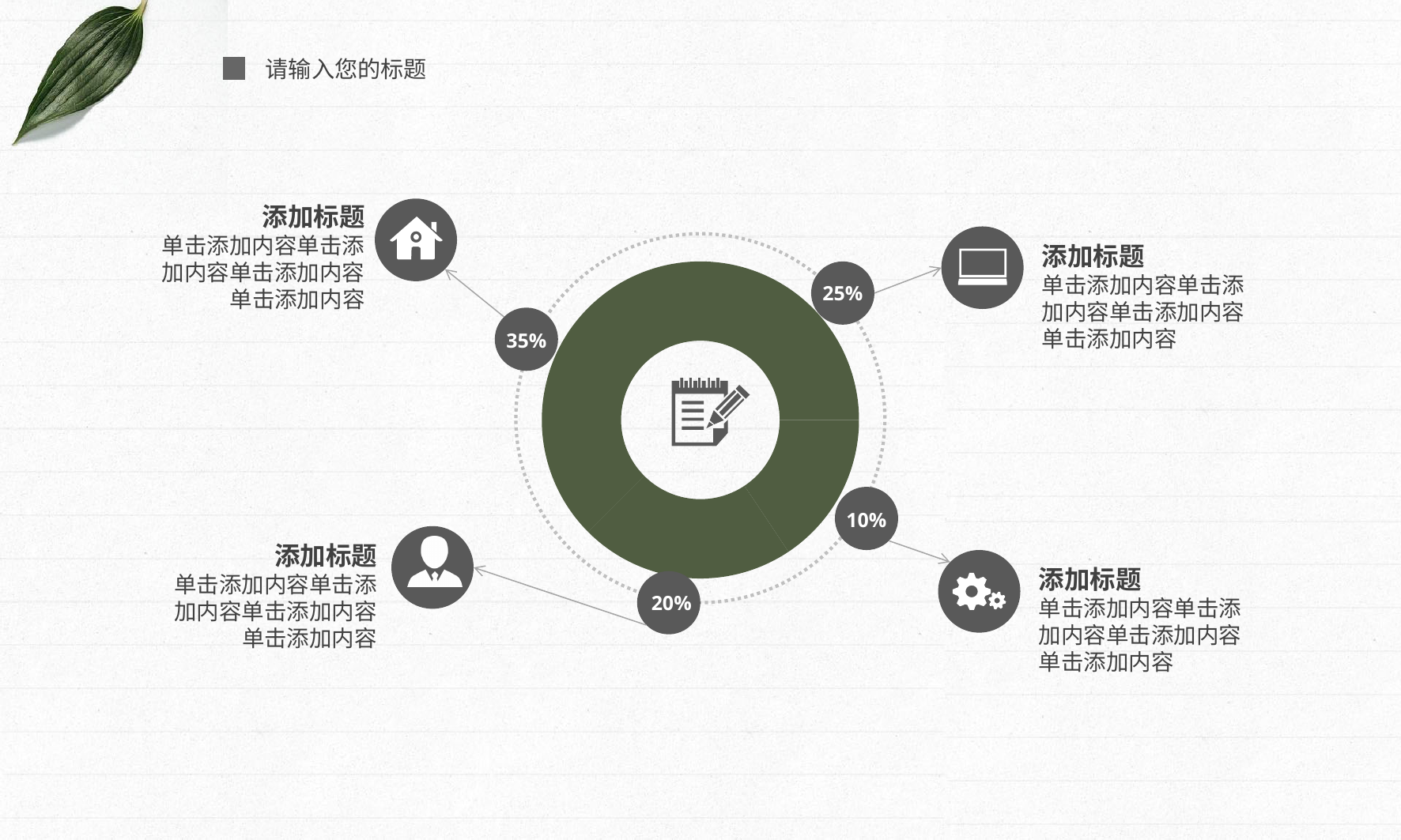
What is the smallest percentage shown on the donut chart? 10% What kind of chart is shown in the centre of the slide? Pie chart (donut) What percentage is linked to the laptop icon? 25% What do the four percentages on the donut chart add up to? 90% What colour is the donut ring of the chart? Dark green How many percentage segments does the donut chart have? 4 What percentage is linked to the gear icon? 10% What is the largest percentage shown on the donut chart? 35% What is the difference between the largest and smallest percentages on the donut chart? 25% Which is larger, the percentage for the laptop icon or the percentage for the person icon? Laptop icon (25%) What percentage is linked to the person icon? 20% What percentage is linked to the house icon? 35%